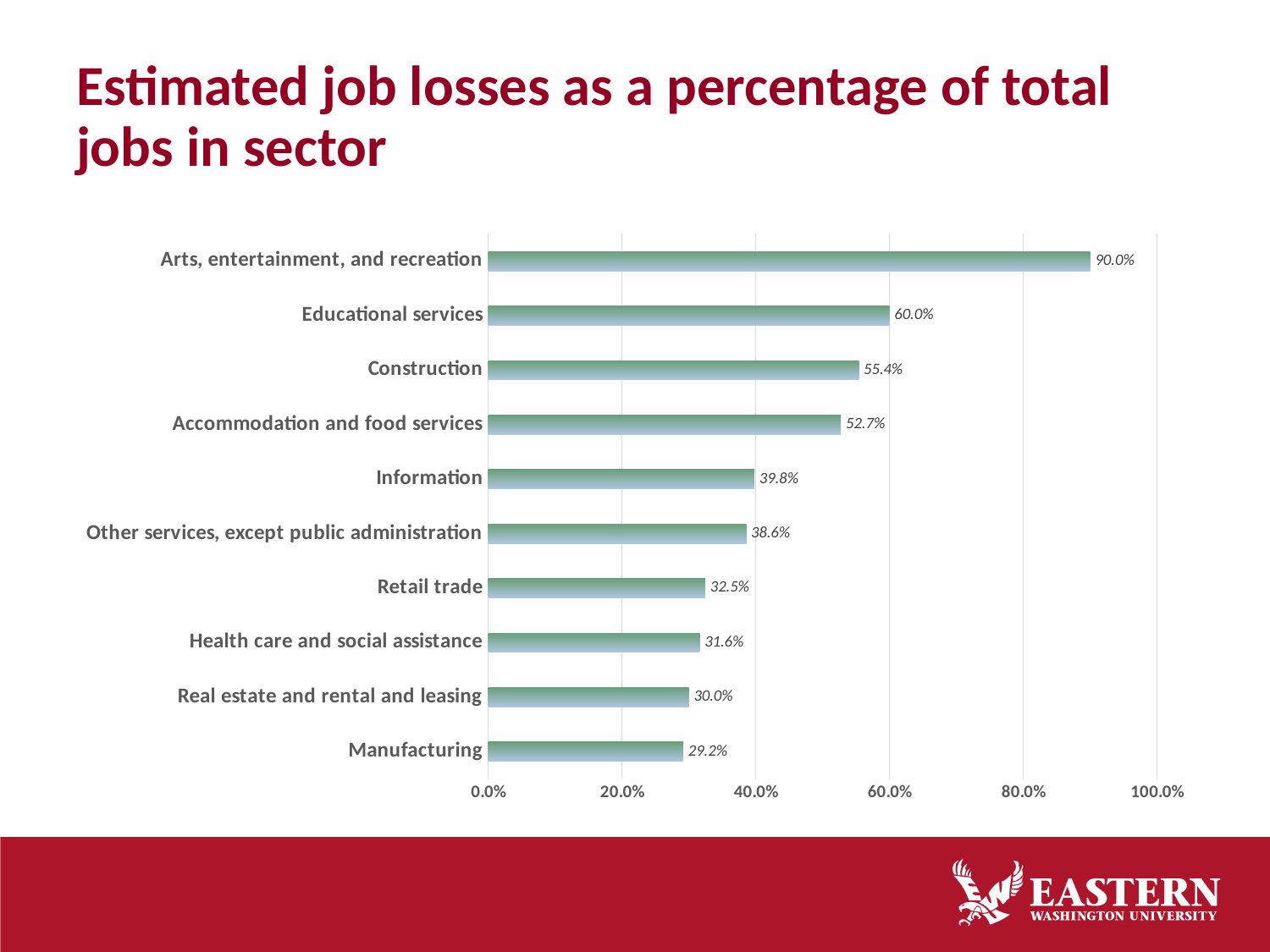
What is the title of the slide? Estimated job losses as a percentage of total jobs in sector How many sectors are shown in the chart? 10 What kind of chart is shown on the slide? Bar chart What is the estimated job loss percentage for Construction? 55.4% What is the difference between the values for Educational services and Accommodation and food services? 7.3% Which sector has the lowest estimated job loss percentage? Manufacturing What is the maximum value shown on the horizontal axis? 100.0% Which is larger, the value for Retail trade or the value for Real estate and rental and leasing? Retail trade What is the value shown for Health care and social assistance? 31.6% Which sector has the highest estimated job loss percentage? Arts, entertainment, and recreation What is the value shown for Information? 39.8% Is the value for Other services, except public administration greater or less than 40.0%? less